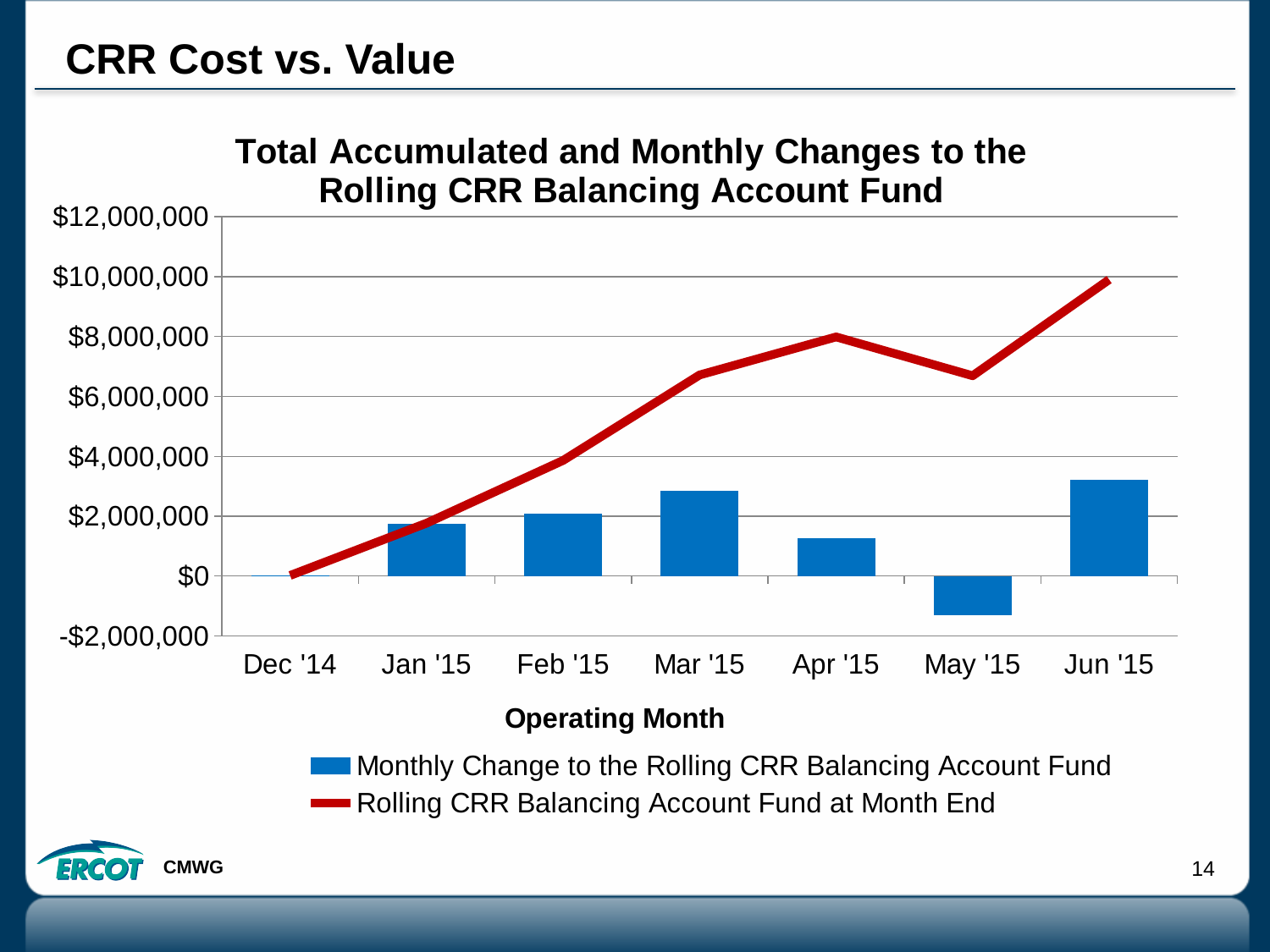
Does the Rolling CRR Balancing Account Fund at Month End generally rise or fall from Dec '14 to Jun '15? Rise What is the title of the x axis? Operating Month How many series does the legend list? 2 Is the Monthly Change to the Rolling CRR Balancing Account Fund for Mar '15 greater or less than $2,000,000? greater Which operating month has the highest Rolling CRR Balancing Account Fund at Month End? Jun '15 What kind of chart is shown on the slide? A combination bar and line chart Which operating month has the highest Monthly Change to the Rolling CRR Balancing Account Fund? Jun '15 Is the Rolling CRR Balancing Account Fund at Month End for Jun '15 greater or less than $8,000,000? greater Is the Monthly Change to the Rolling CRR Balancing Account Fund for May '15 greater or less than $0? less Which is larger, the Rolling CRR Balancing Account Fund at Month End for Apr '15 or for May '15? Apr '15 Which operating month has the lowest Monthly Change to the Rolling CRR Balancing Account Fund? May '15 How many operating months are shown on the x axis? 7